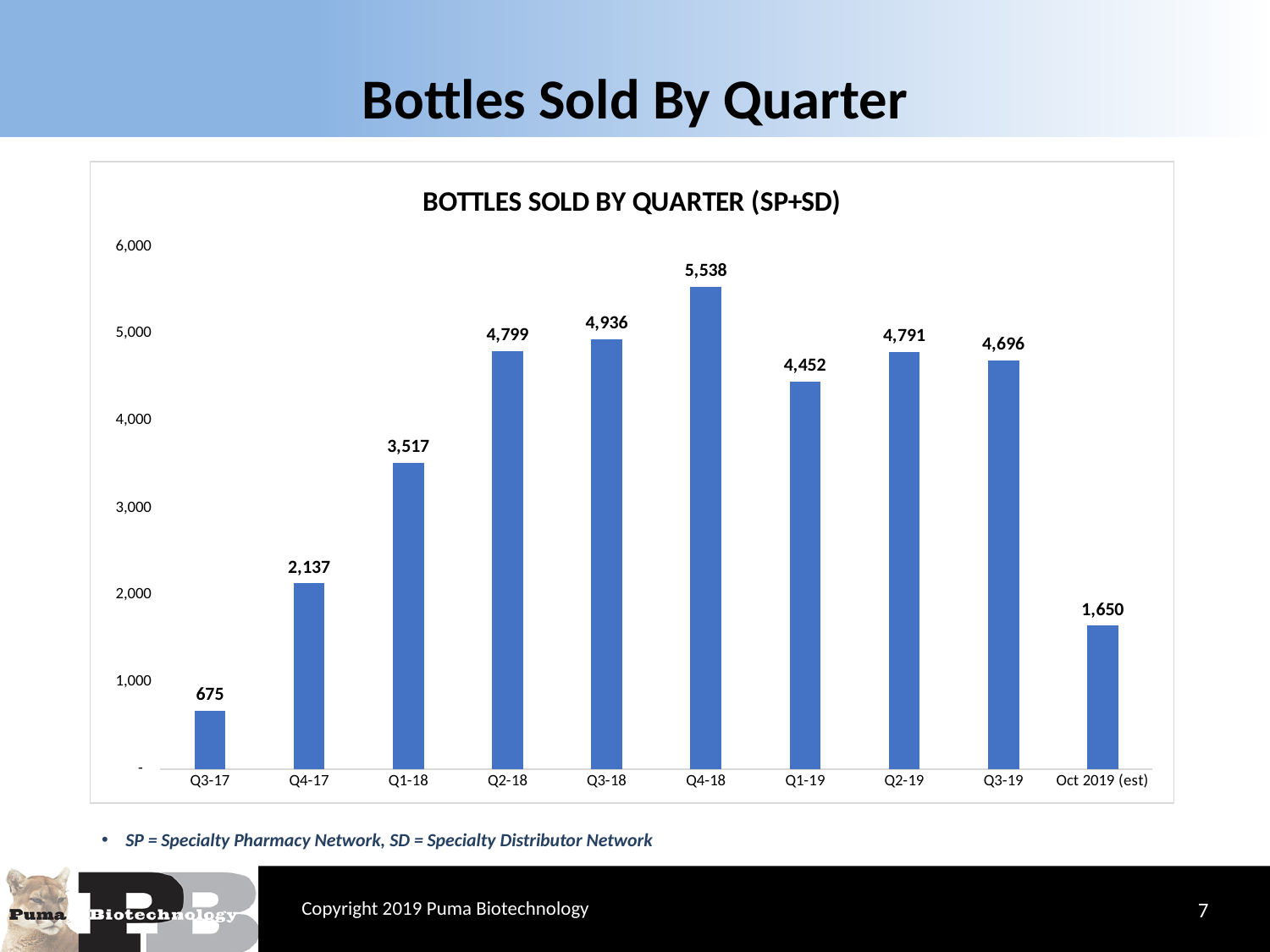
Do the values rise or fall from Q3-17 to Q4-18? Rise Is the value for Q1-18 greater or less than 3,000? greater What is the difference between the bottles sold in Q4-18 and Q1-19? 1,086 How many categories are shown on the x axis? 10 What is the title of the chart? BOTTLES SOLD BY QUARTER (SP+SD) What is the value shown for Q3-17? 675 How many bottles were sold in Q4-18? 5,538 Which category has the lowest value on the chart? Q3-17 Which is larger, the value for Q2-18 or the value for Q2-19? Q2-18 What kind of chart is shown on the slide? Bar chart Which quarter has the highest number of bottles sold? Q4-18 What is the estimated number of bottles for Oct 2019 (est)? 1,650